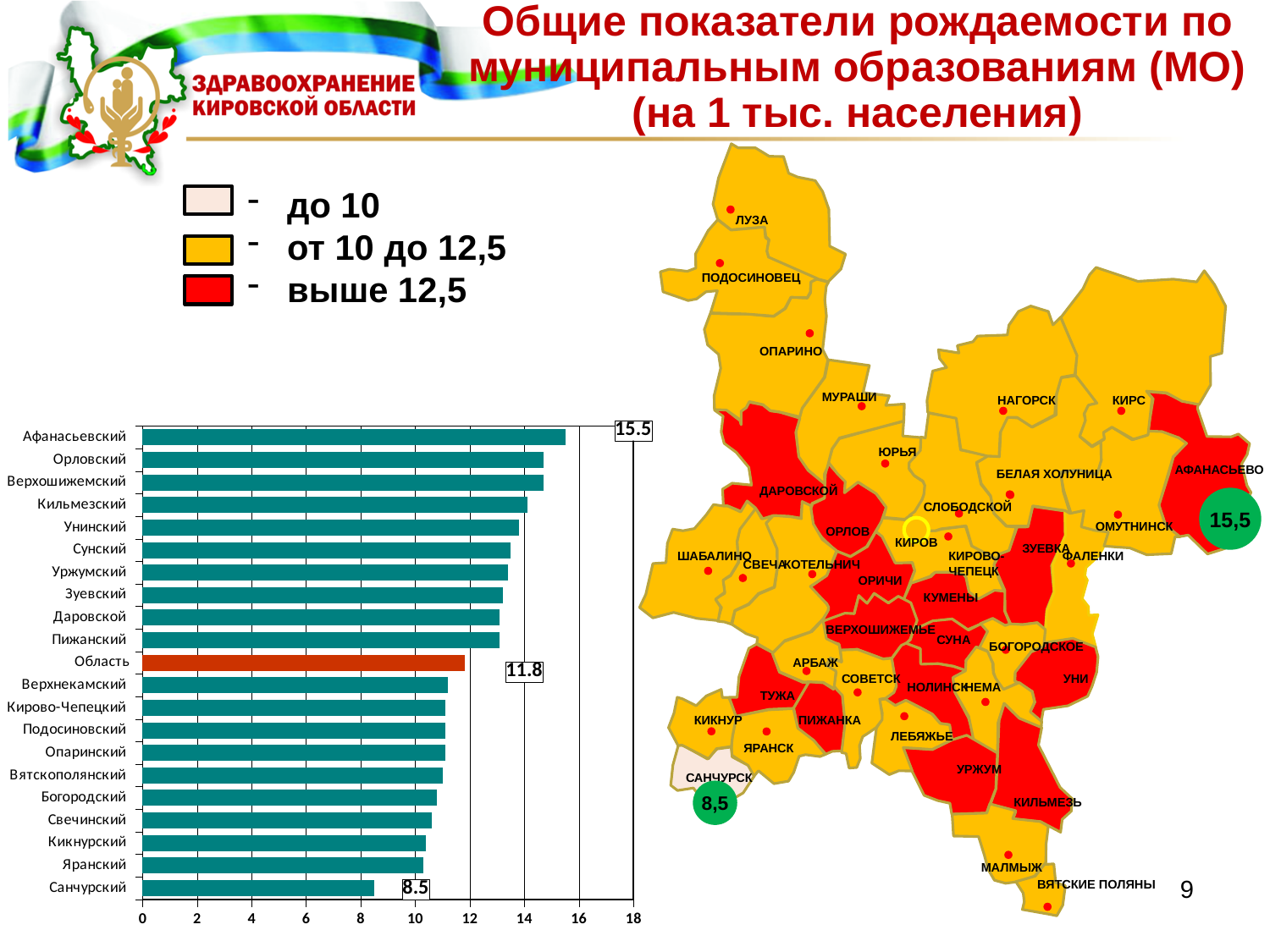
What is the value for Область in the bar chart? 11.8 What kind of chart is shown on the left of the slide? bar chart Which category has the highest value in the bar chart? Афанасьевский How many categories are shown in the bar chart? 21 What is the value for Санчурский in the bar chart? 8.5 Is the value for Орловский in the bar chart greater or less than 14? greater Which is larger in the bar chart, the value for Орловский or the value for Яранский? Орловский What is the difference between the values for Афанасьевский and Область in the bar chart? 3.7 What is the value for Афанасьевский in the bar chart? 15.5 What is the difference between the values for Афанасьевский and Санчурский in the bar chart? 7 Is the value for Верхнекамский in the bar chart greater or less than 12? less Which category has the lowest value in the bar chart? Санчурский